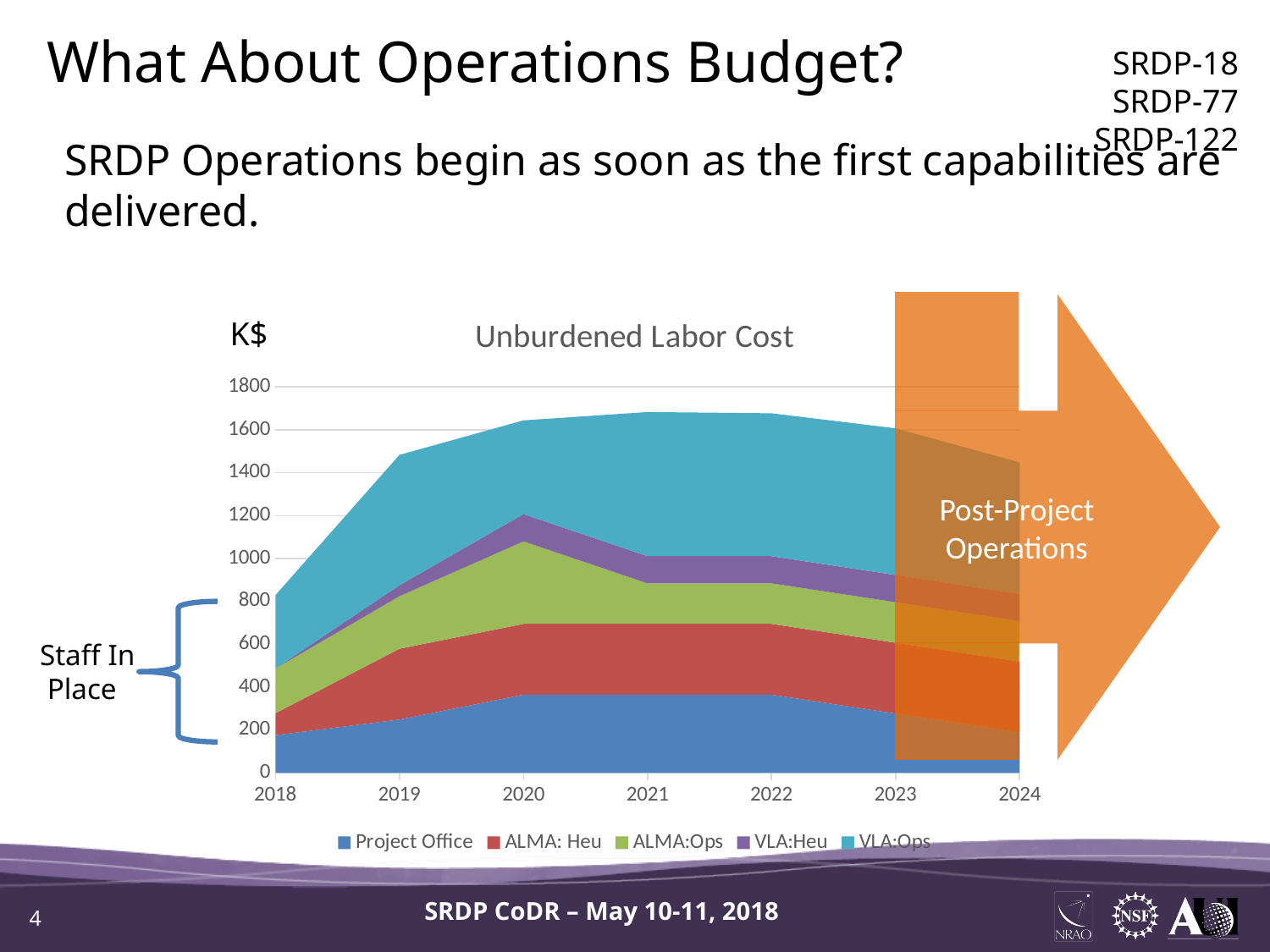
What unit is shown for the y axis of the chart? K$ Does the total unburdened labor cost rise or fall from 2018 to 2020? rise What is the title of the chart? Unburdened Labor Cost Which year has the lowest total unburdened labor cost? 2018 Is the total unburdened labor cost in 2021 greater or less than 1600? greater How many series does the chart legend list? 5 Is the Project Office value in 2020 greater or less than 200? greater Is the total unburdened labor cost in 2018 greater or less than 1000? less How many years are shown along the x axis of the chart? 7 What kind of chart is shown on the slide? Stacked area chart